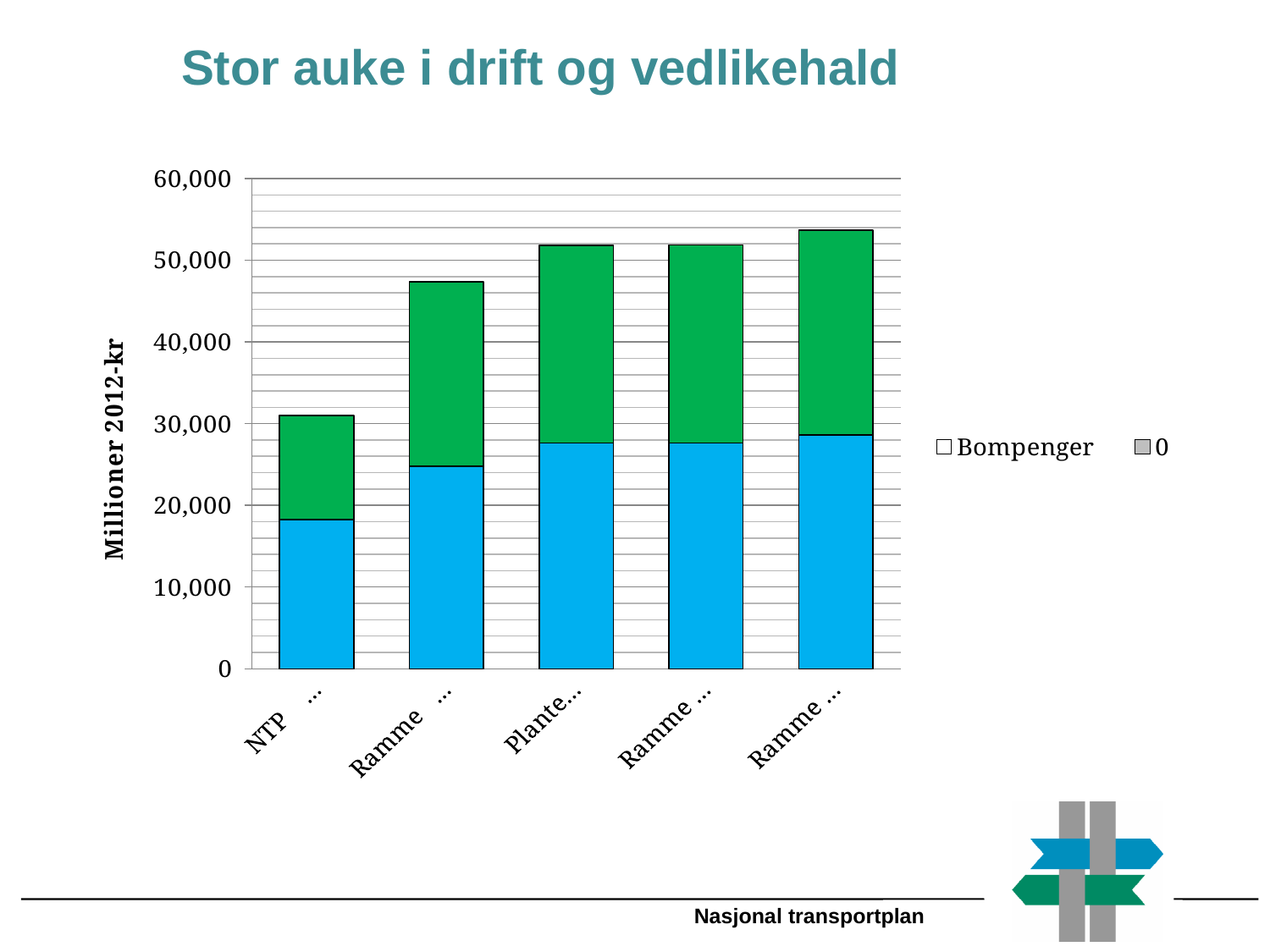
How many series does the legend list? 2 Which bar has the lowest total value? the first bar (NTP ...) Which bar has the highest total value? the fifth (rightmost) bar What is the title of the vertical axis? Millioner 2012-kr Is the total value of the first bar greater or less than 40,000? less How many bars (categories) are plotted in the chart? 5 What are the two entries in the legend? Bompenger and 0 Is the total value of the fifth bar greater or less than 50,000? greater Do the bar totals generally rise or fall from left to right? rise Is the total value of the second bar greater or less than 50,000? less What kind of chart is shown on the slide? stacked bar chart